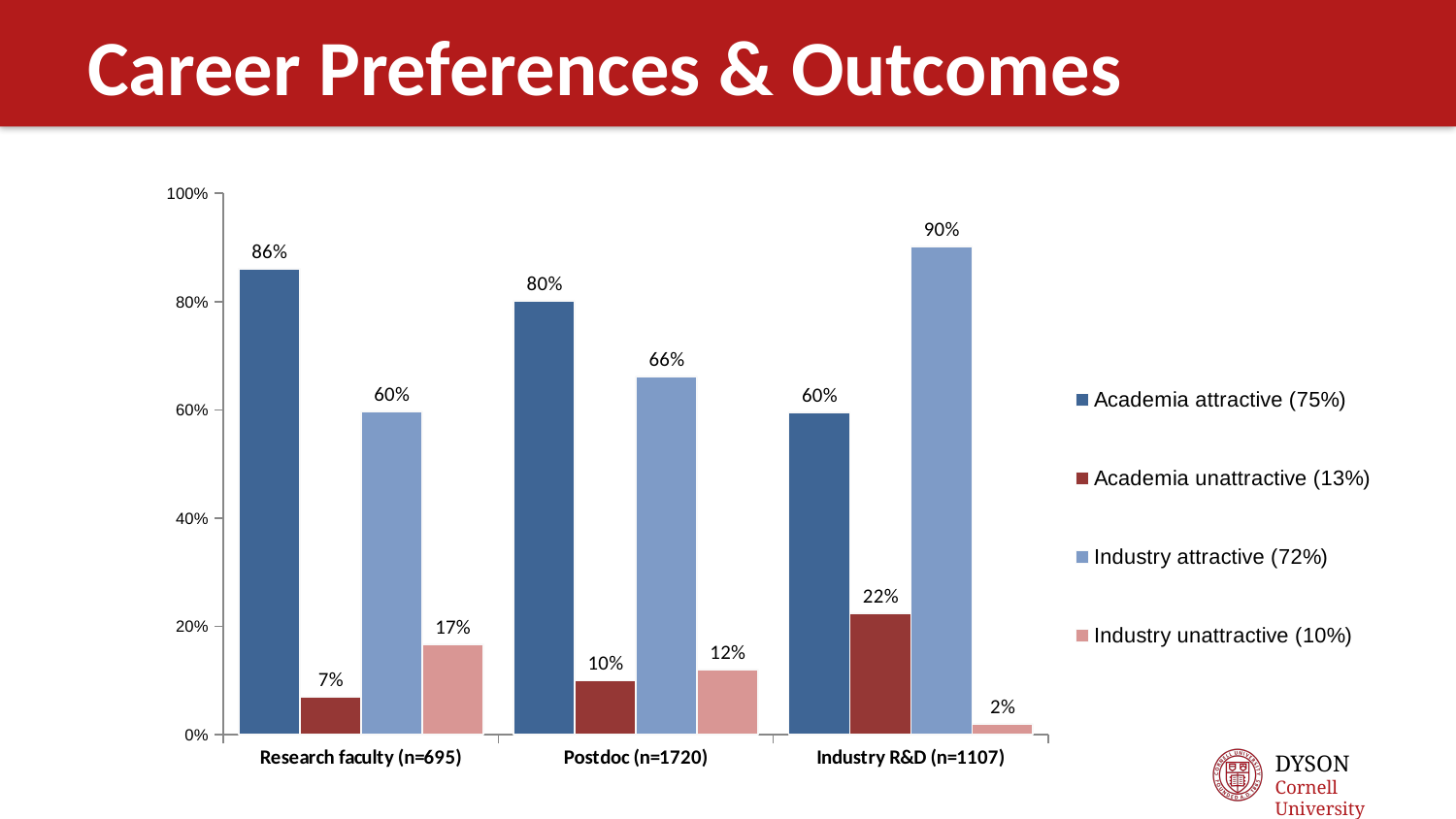
What is the value for Industry attractive in the Industry R&D (n=1107) category? 90% Is the value for Industry attractive in the Research faculty (n=695) category greater or less than 40%? greater Does the value for Academia attractive rise or fall across the categories from left to right? Fall What is the value for Academia attractive in the Research faculty (n=695) category? 86% Which category has the lowest value for Industry unattractive? Industry R&D (n=1107) Which is larger in the Industry R&D (n=1107) category: Academia attractive or Industry attractive? Industry attractive What kind of chart is shown on the slide? Bar chart How many categories are shown on the x axis? 3 What is the difference between Academia attractive and Industry attractive in the Postdoc (n=1720) category? 14% Which category has the highest value for Industry attractive? Industry R&D (n=1107) How many series does the legend list? 4 What is the value for Academia unattractive in the Postdoc (n=1720) category? 10%